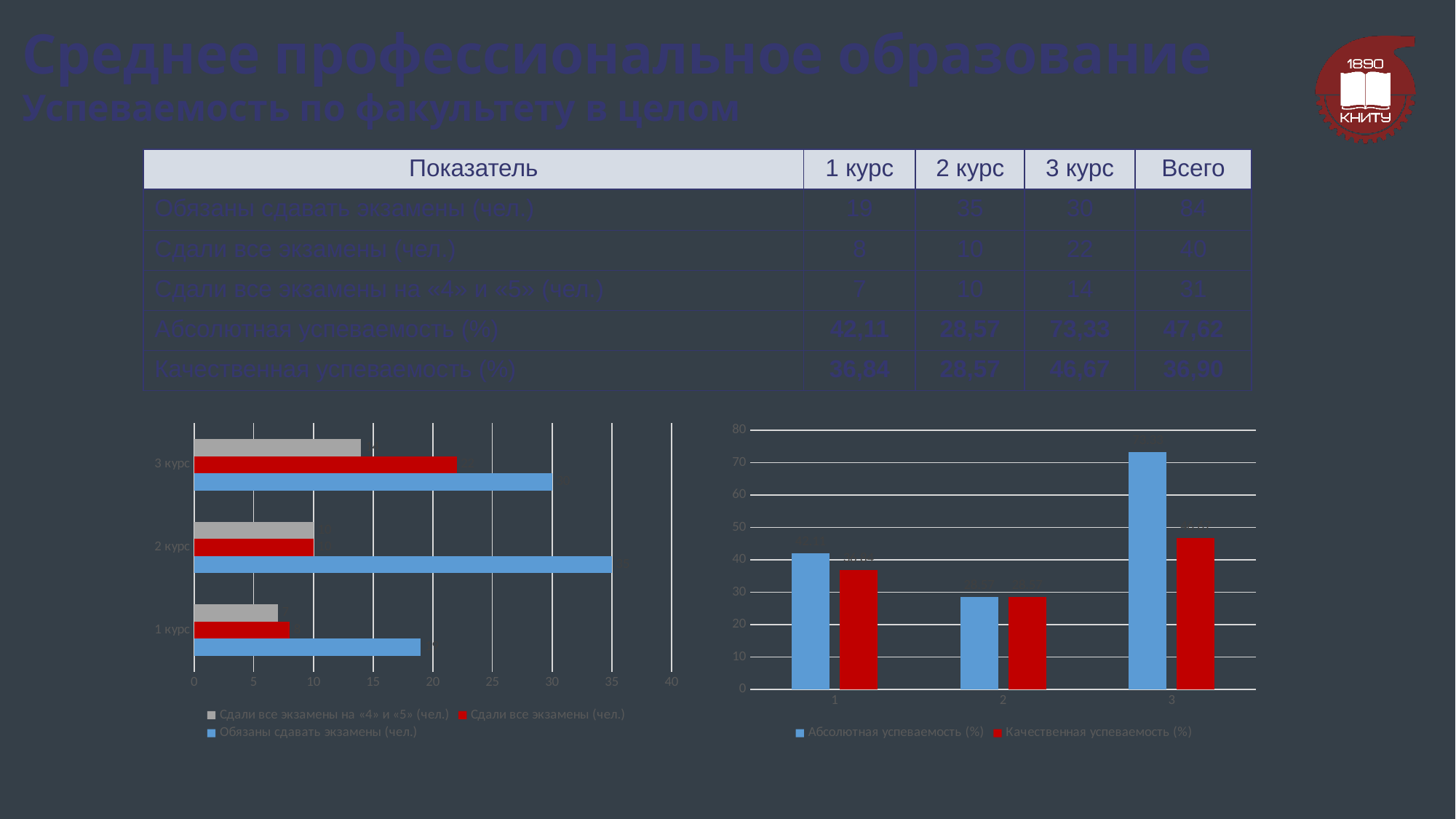
How many categories are shown on the left chart? 3 In the left chart, is the value of Обязаны сдавать экзамены (чел.) for 1 курс greater or less than 20? less In the left chart, what is the value of Обязаны сдавать экзамены (чел.) for 3 курс? 30 How many series does the legend of the left chart list? 3 In the left chart, which category has the highest value for Обязаны сдавать экзамены (чел.)? 2 курс In the left chart, what is the value of Сдали все экзамены (чел.) for 2 курс? 10 How many series does the legend of the right chart list? 2 What kind of chart is the chart on the left of the slide? bar chart In the right chart, which category has the highest value for Абсолютная успеваемость (%)? 3 In the left chart, which is larger for 3 курс: Сдали все экзамены (чел.) or Сдали все экзамены на «4» и «5» (чел.)? Сдали все экзамены (чел.) In the right chart, is the value of Абсолютная успеваемость (%) for category 3 greater or less than 70? greater In the left chart, what is the value of Обязаны сдавать экзамены (чел.) for 2 курс? 35